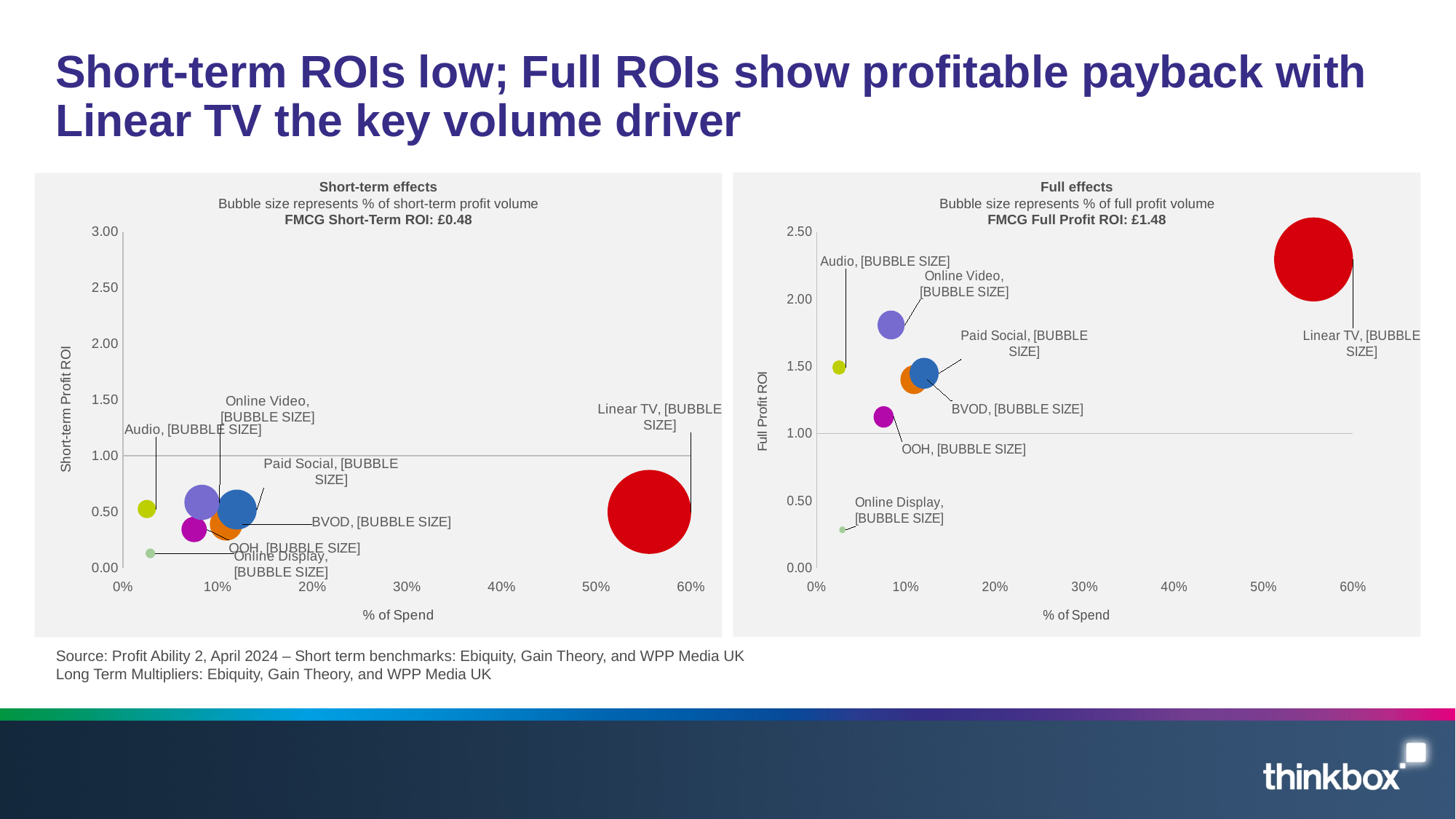
In the 'Full effects' chart, is the Full Profit ROI for Online Display greater or less than 0.50? less What FMCG Full Profit ROI is stated in the title of the 'Full effects' chart? £1.48 How many channel bubbles are plotted in the 'Full effects' chart? 7 In the 'Short-term effects' chart, is the Short-term Profit ROI for Linear TV greater or less than 1.00? less In the 'Full effects' chart, which channel has the lowest Full Profit ROI? Online Display In the 'Full effects' chart, is the % of Spend for Linear TV greater or less than 50%? greater In the 'Full effects' chart, which has the higher Full Profit ROI, Online Video or OOH? Online Video In the 'Short-term effects' chart, which channel has the lowest Short-term Profit ROI? Online Display In the 'Full effects' chart, which channel has the highest Full Profit ROI? Linear TV What kind of chart is the 'Short-term effects' chart? bubble chart In the 'Short-term effects' chart, which channel has the largest bubble? Linear TV